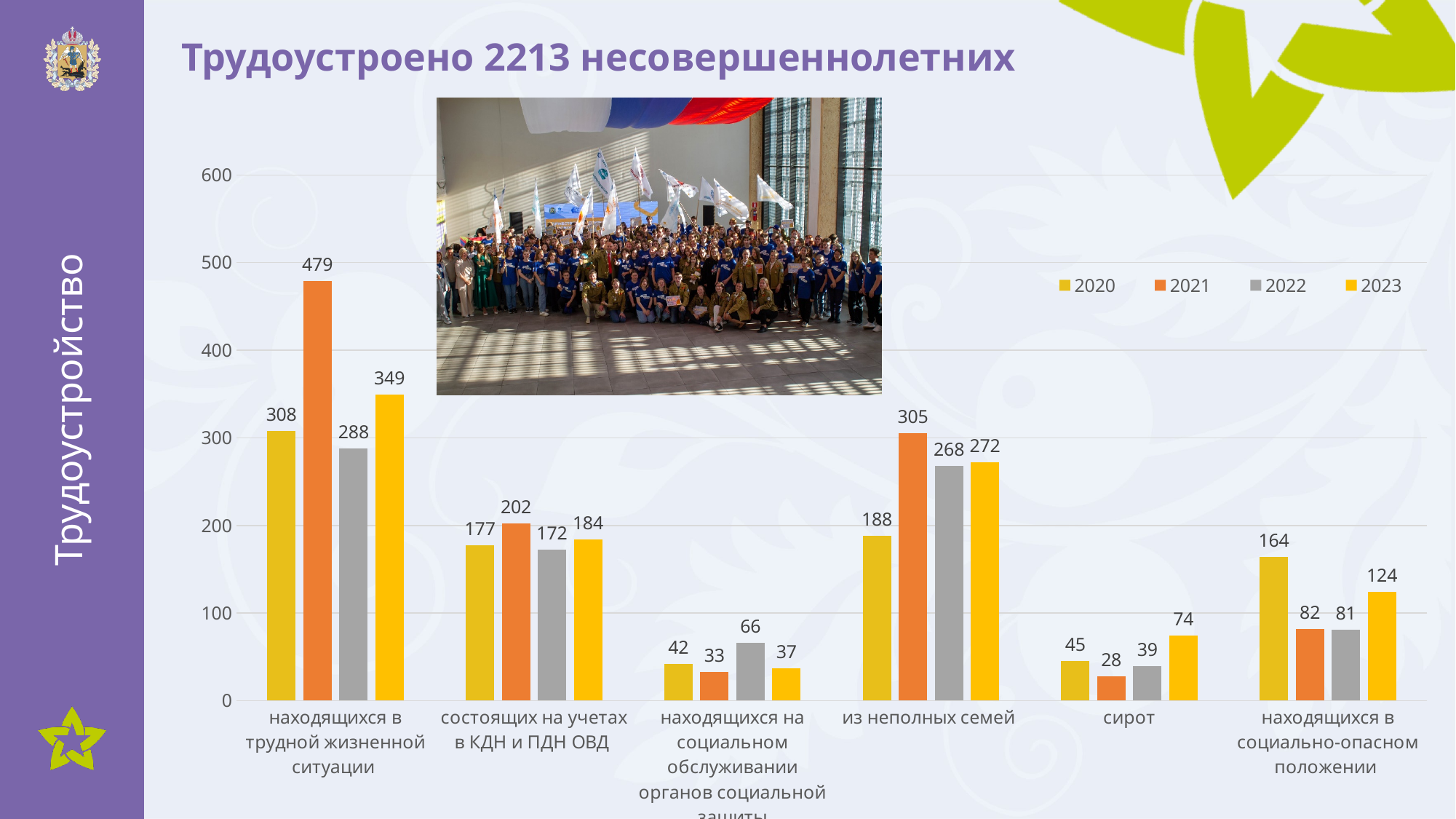
Which year has the lowest value in the category "сирот"? 2021 Which year has the highest value in the category "находящихся в социально-опасном положении"? 2020 What is the value for 2022 in the category "из неполных семей"? 268 How many categories are shown on the x axis of the chart? 6 What is the value for 2021 in the category "находящихся в трудной жизненной ситуации"? 479 What is the title of the slide above the chart? Трудоустроено 2213 несовершеннолетних What is the value for 2023 in the category "сирот"? 74 How many series does the legend list? 4 Is the value for 2023 in the category "находящихся в трудной жизненной ситуации" greater or less than 300? greater What kind of chart is shown on the slide? bar chart Which is larger in the category "состоящих на учетах в КДН и ПДН ОВД": the value for 2021 or the value for 2023? 2021 What is the difference between the 2021 and 2020 values in the category "из неполных семей"? 117